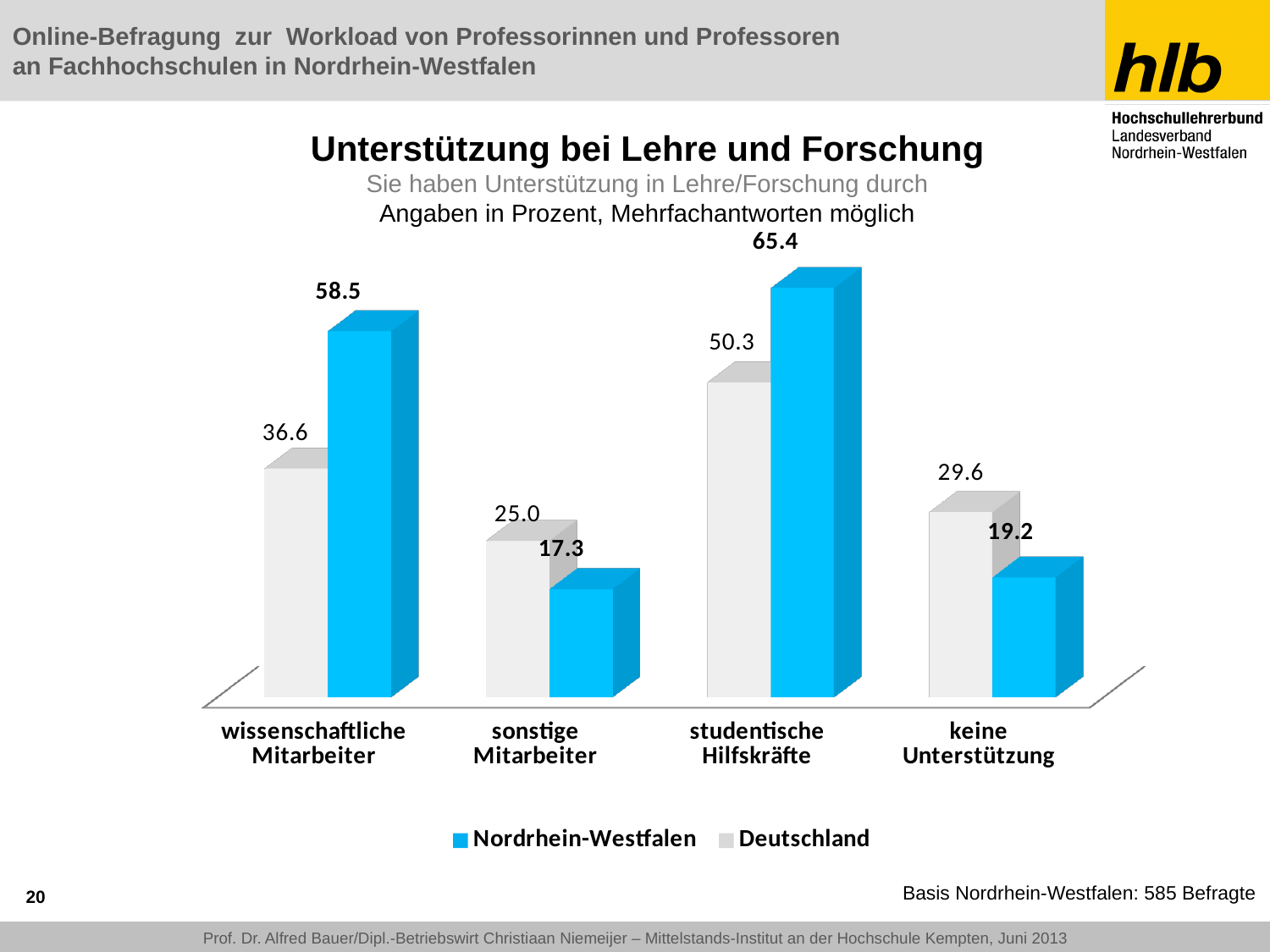
What kind of chart is shown on the slide? bar chart What is the value for Nordrhein-Westfalen for keine Unterstützung? 19.2 What is the difference between the Nordrhein-Westfalen and Deutschland values for wissenschaftliche Mitarbeiter? 21.9 How many series does the legend list? 2 What is the value for Nordrhein-Westfalen for wissenschaftliche Mitarbeiter? 58.5 Which category has the highest value for Nordrhein-Westfalen? studentische Hilfskräfte How many categories are shown on the x axis? 4 Which category has the lowest value for Deutschland? sonstige Mitarbeiter What is the value for Deutschland for sonstige Mitarbeiter? 25.0 Which series is shown in blue? Nordrhein-Westfalen What is the value for Deutschland for studentische Hilfskräfte? 50.3 For keine Unterstützung, which is larger: the value for Nordrhein-Westfalen or for Deutschland? Deutschland